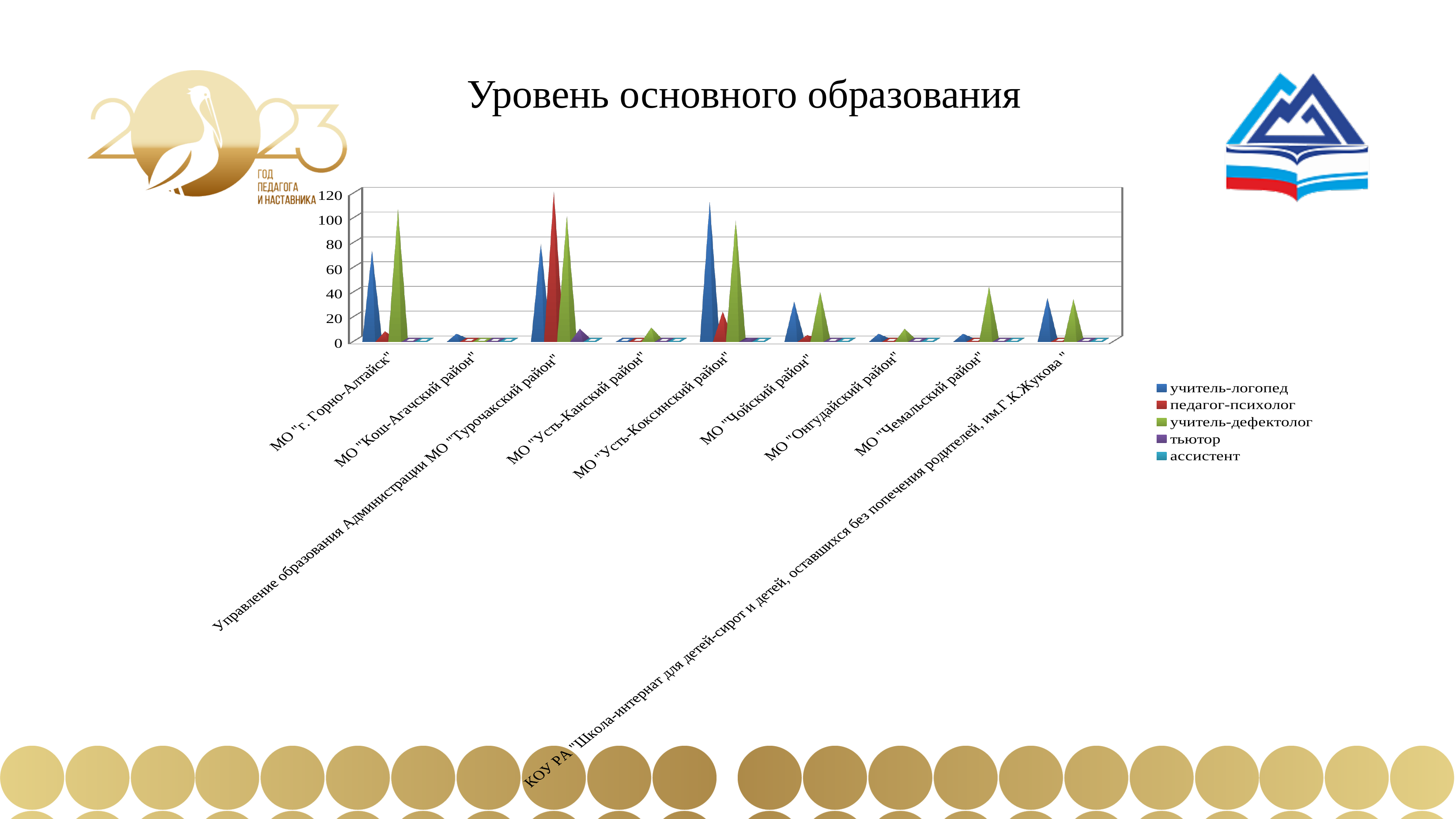
Is the value for учитель-логопед in МО "Усть-Коксинский район" greater or less than 100? greater What kind of chart is shown on the slide? bar chart Is the value for учитель-дефектолог in МО "г. Горно-Алтайск" greater or less than 80? greater Is the value for педагог-психолог in Управление образования Администрации МО "Турочакский район" greater or less than 100? greater How many series does the legend list? 5 Which category has the highest value for педагог-психолог? Управление образования Администрации МО "Турочакский район" Which category has the highest value for учитель-логопед? МО "Усть-Коксинский район" How many categories are shown on the x axis? 9 In МО "г. Горно-Алтайск", which is larger: учитель-логопед or учитель-дефектолог? учитель-дефектолог What is the title of the chart? Уровень основного образования